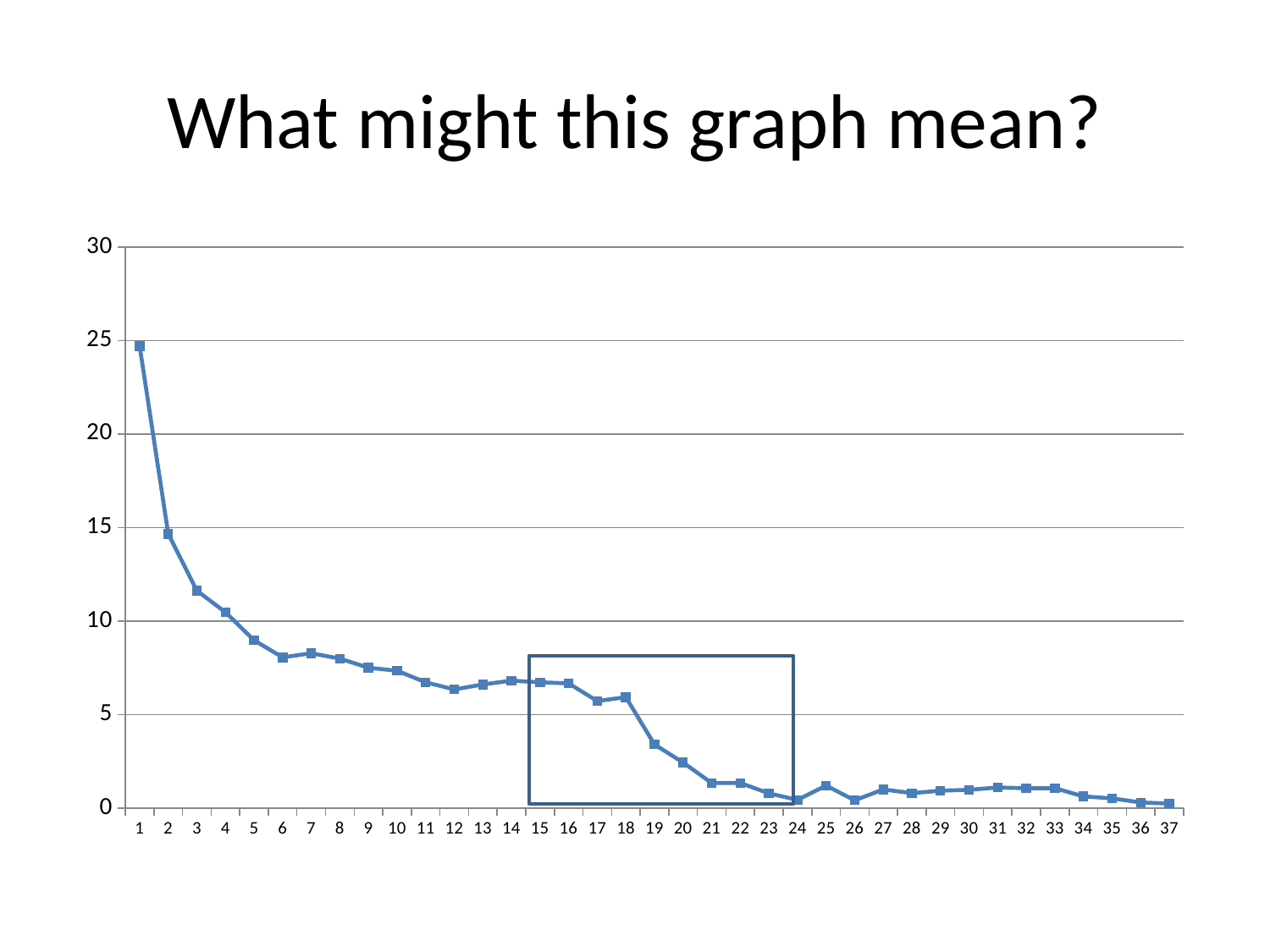
How many points are plotted along the x axis? 37 Which x-axis category has the highest value? 1 Is the value at x = 5 greater or less than 10? less Is the value at x = 1 greater or less than 20? greater Which x-axis categories does the rectangle drawn on the chart enclose? 15 to 24 Is the value at x = 3 greater or less than 10? greater Overall, do the values rise or fall from left to right along the x axis? fall Which has the larger value, x = 1 or x = 2? 1 What kind of chart is shown on the slide? line chart Which has the larger value, x = 18 or x = 19? 18